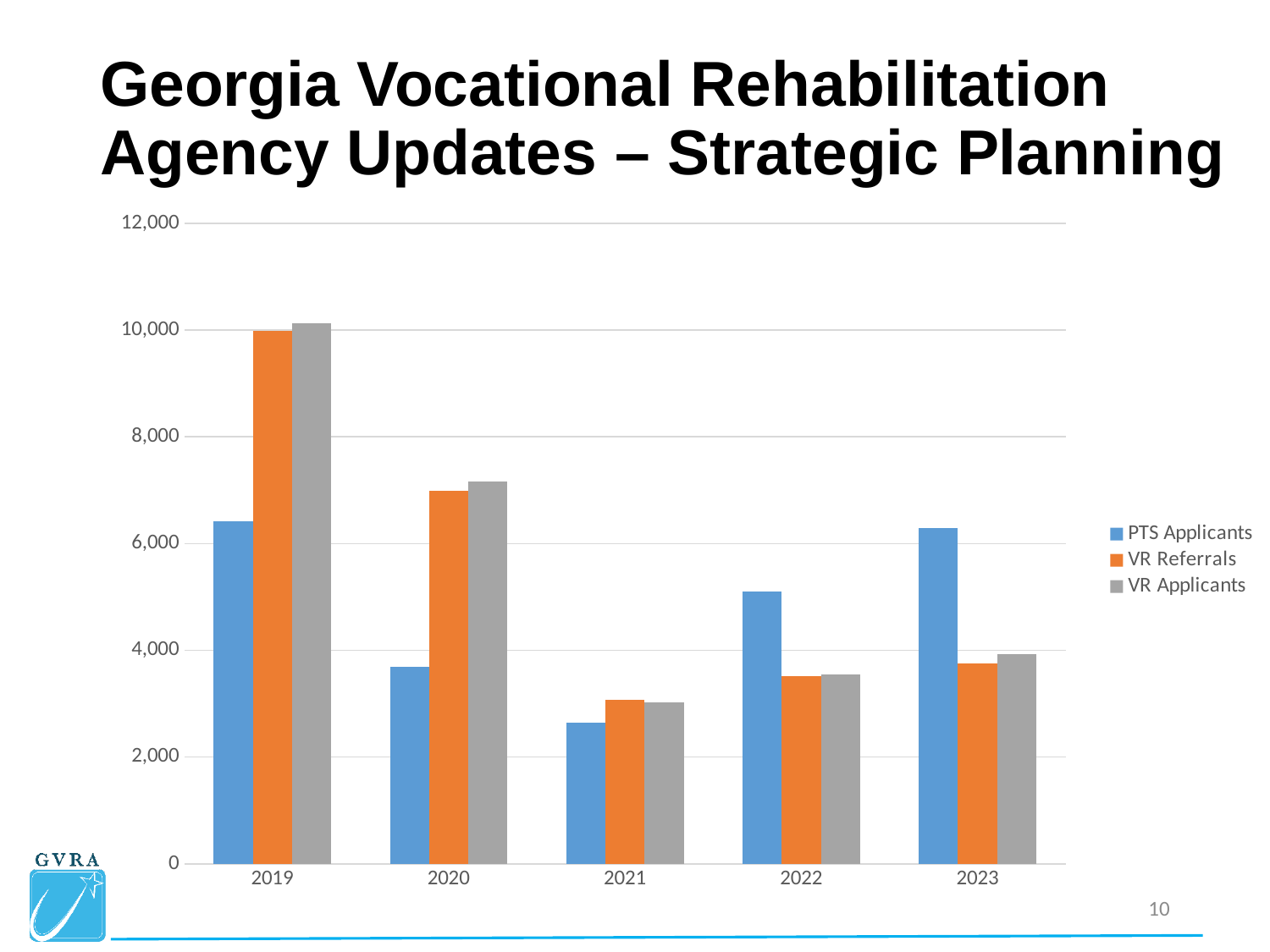
How many years are shown on the x axis? 5 In which year are PTS Applicants lowest? 2021 Do VR Referrals rise or fall from 2019 to 2021? fall Is the value for VR Referrals in 2020 greater or less than 8,000? less What kind of chart is shown on the slide? bar chart Which colour represents VR Referrals in the legend? orange Is the value for PTS Applicants in 2019 greater or less than 6,000? greater In which year are VR Referrals highest? 2019 In 2022, which is larger: PTS Applicants or VR Referrals? PTS Applicants Is the value for PTS Applicants in 2022 greater or less than 4,000? greater How many series does the legend list? 3